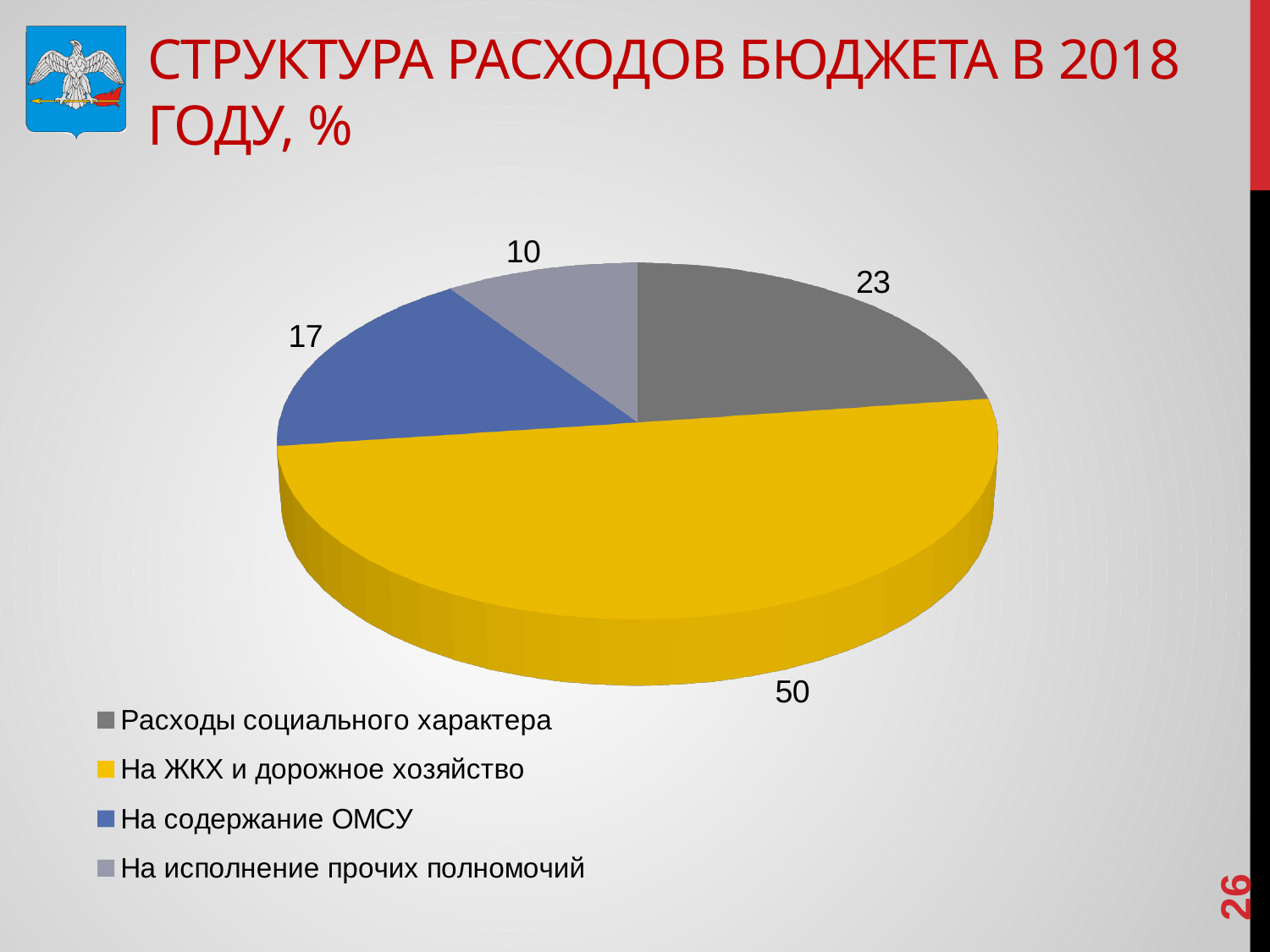
What is the value for "На исполнение прочих полномочий"? 10 Which category has the smallest share of the pie? На исполнение прочих полномочий Which category has the largest share of the pie? На ЖКХ и дорожное хозяйство What is the difference between the values for "На ЖКХ и дорожное хозяйство" and "Расходы социального характера"? 27 What is the value for "Расходы социального характера"? 23 What colour is the slice for "На ЖКХ и дорожное хозяйство"? Yellow What type of chart is shown on the slide? Pie chart Which is larger: the value for "На содержание ОМСУ" or the value for "На исполнение прочих полномочий"? На содержание ОМСУ What is the value for "На ЖКХ и дорожное хозяйство"? 50 What is the title of the chart on the slide? СТРУКТУРА РАСХОДОВ БЮДЖЕТА В 2018 ГОДУ, % What is the value for "На содержание ОМСУ"? 17 How many categories does the pie chart show? 4